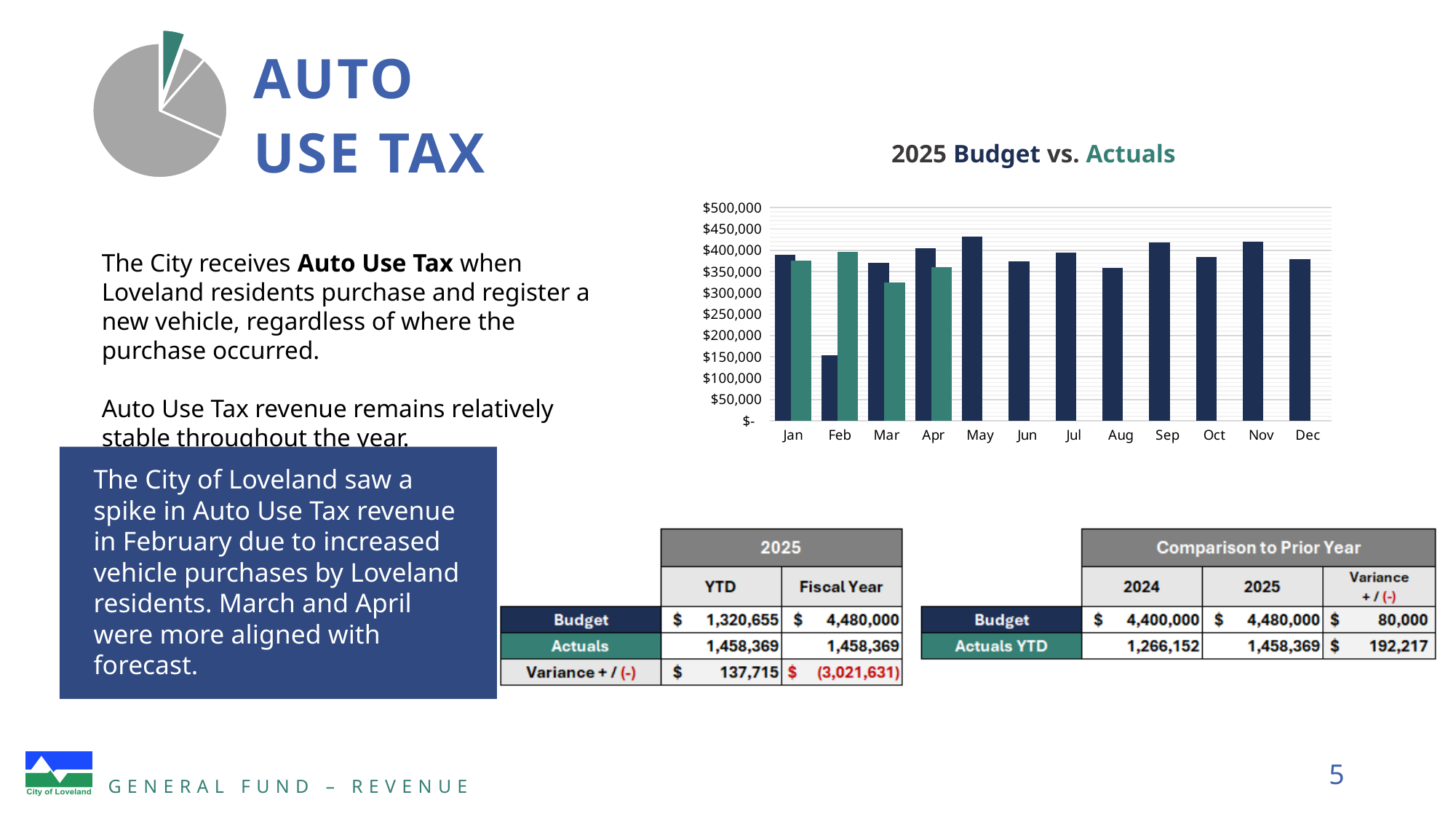
What is the title of the bar chart on the slide? 2025 Budget vs. Actuals In the "2025 Budget vs. Actuals" chart, which is the only month where the Actuals bar is taller than the Budget bar? Feb In the "2025 Budget vs. Actuals" chart, which is larger for Mar, the Budget bar or the Actuals bar? Budget In the "2025 Budget vs. Actuals" chart, is the Actuals value for Mar greater or less than $350,000? less In the "2025 Budget vs. Actuals" chart, which is larger for Feb, the Budget bar or the Actuals bar? Actuals In the "2025 Budget vs. Actuals" chart, how many months have an Actuals bar plotted? 4 How many months are shown on the x axis of the "2025 Budget vs. Actuals" chart? 12 In the "2025 Budget vs. Actuals" chart, is the Actuals value for Feb greater or less than $350,000? greater In the "2025 Budget vs. Actuals" chart, which month has the lowest Budget bar? Feb In the "2025 Budget vs. Actuals" chart, is the Budget value for May greater or less than $400,000? greater What kind of chart is the "2025 Budget vs. Actuals" chart? bar chart